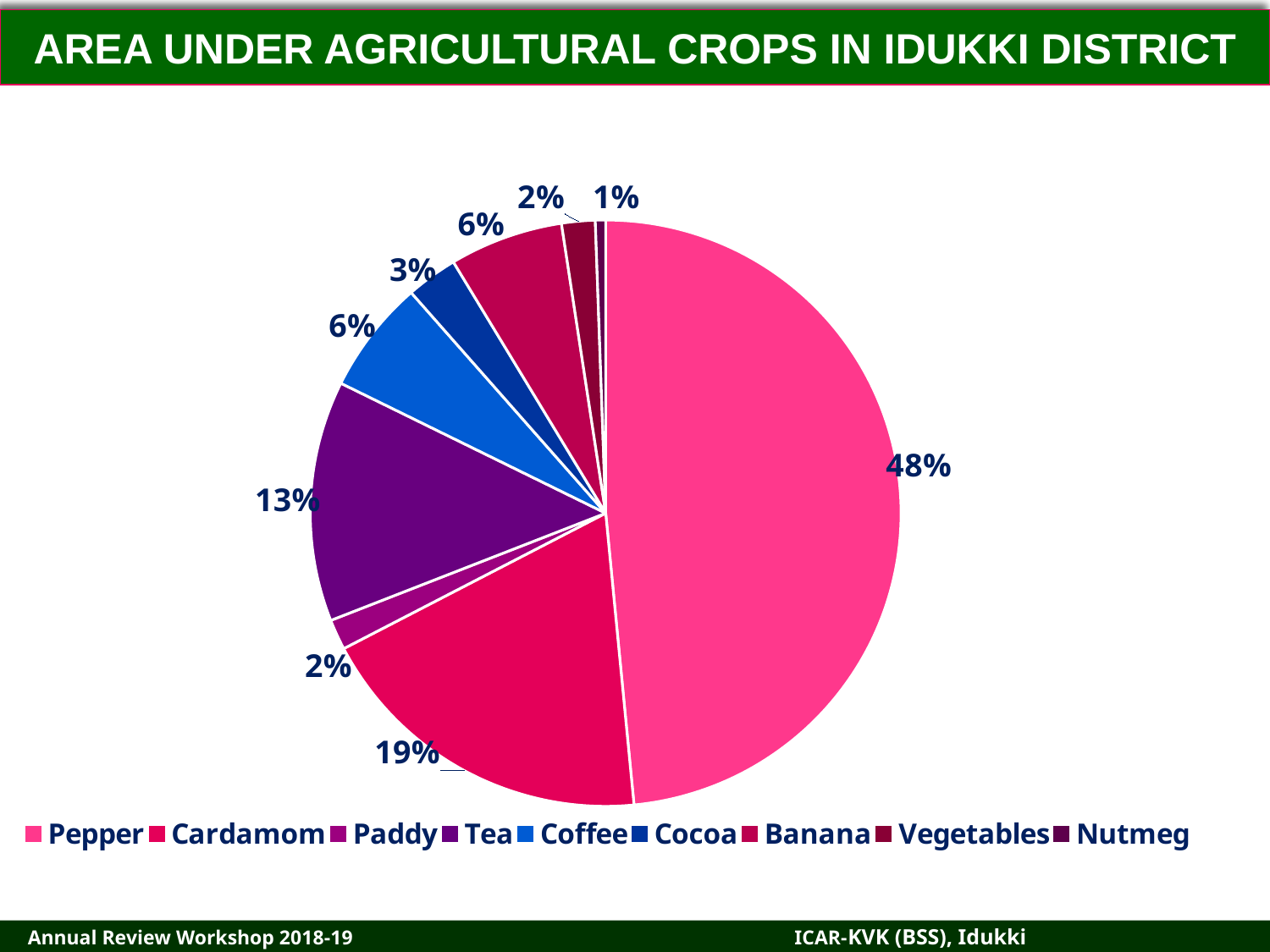
Which crop has the largest share of the area? Pepper What share of the area under agricultural crops is Pepper? 48% Which crop has the smallest share of the area? Nutmeg Which has a larger share, Tea or Coffee? Tea What share of the pie does Cardamom represent? 19% What is the title of the chart? AREA UNDER AGRICULTURAL CROPS IN IDUKKI DISTRICT What percentage is shown for Tea? 13% How many crops are shown in the pie chart? 9 What percentage is shown for Cocoa? 3% What type of chart is shown on the slide? pie chart Which crop is listed last in the legend? Nutmeg What is the difference in percentage points between Pepper and Cardamom? 29